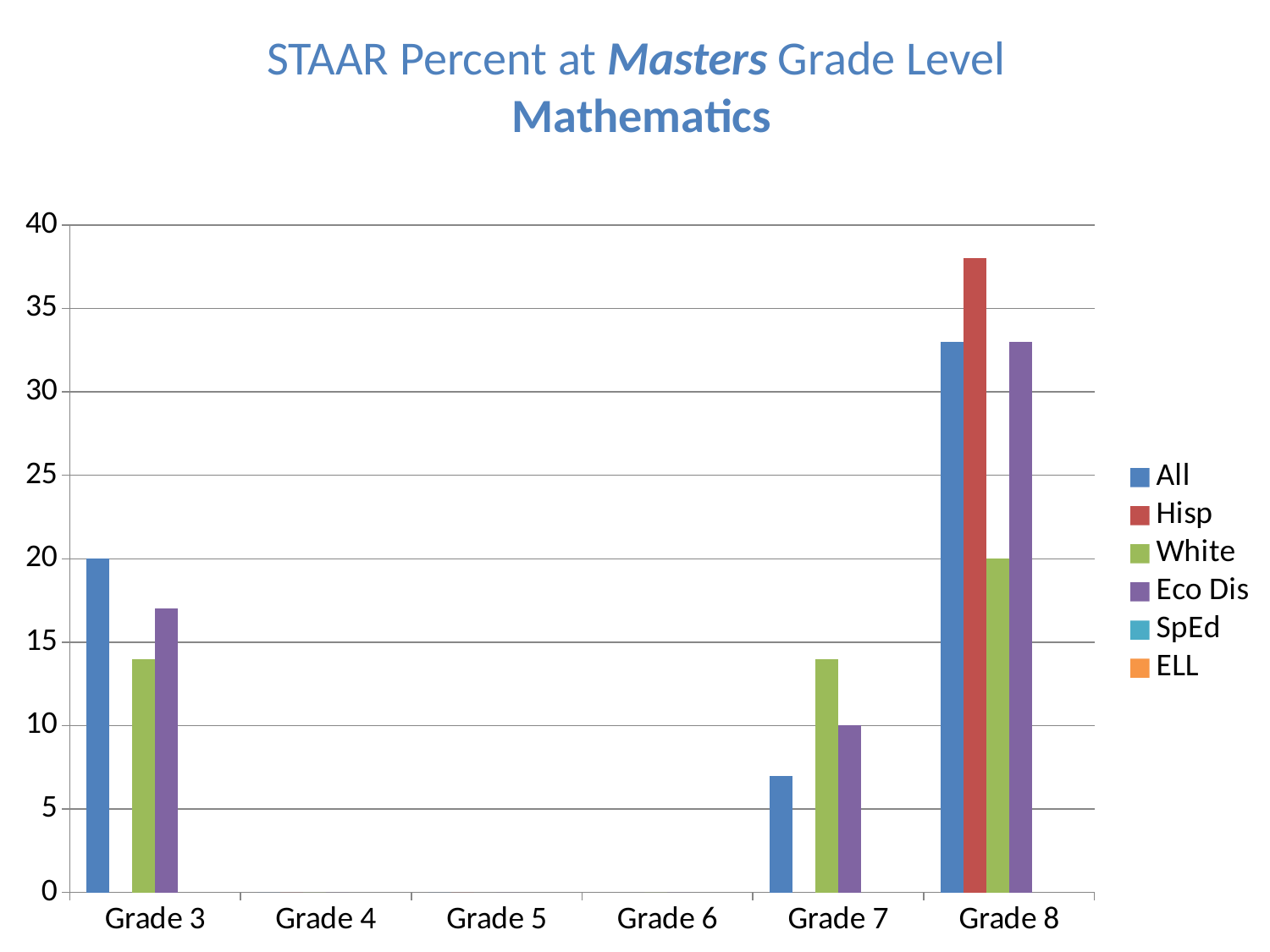
Is the value for Hisp in Grade 8 greater or less than 35? greater What subject is named in the chart title? Mathematics What is the value for White in Grade 8? 20 Is the value for All in Grade 7 greater or less than 5? greater What kind of chart is shown on the slide? bar chart How many series does the legend list? 6 Which series has the tallest bar in Grade 8? Hisp What is the value for Eco Dis in Grade 7? 10 Is the value for All in Grade 8 greater or less than 30? greater Which is larger, the All value for Grade 3 or the All value for Grade 8? Grade 8 What is the value for All in Grade 3? 20 How many grade categories are shown on the x axis? 6